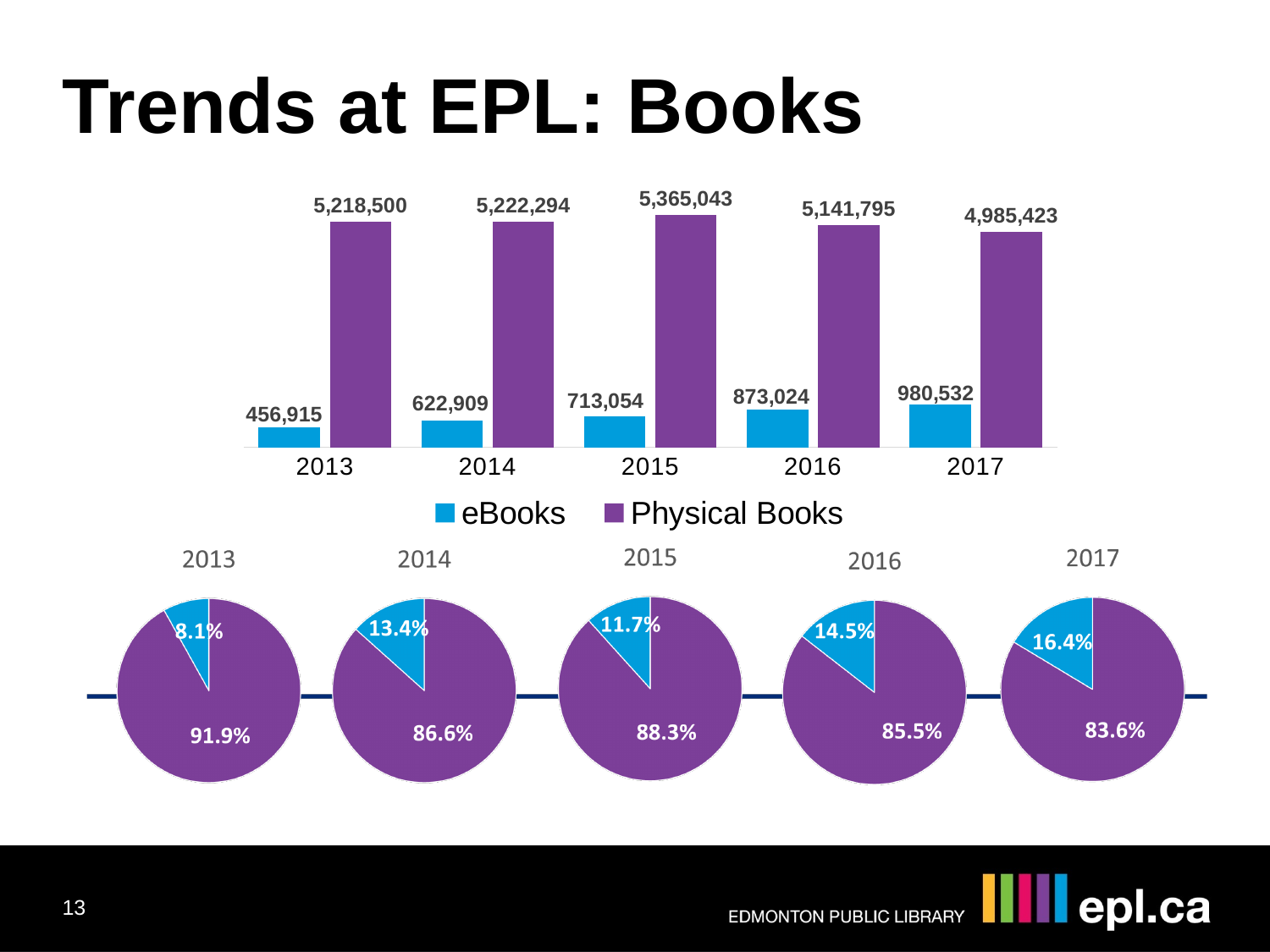
In the bar chart, what is the value for eBooks in 2015? 713,054 In the bar chart, which year has the highest value for Physical Books? 2015 What kind of chart is the top chart on the slide? bar chart How many series does the legend of the bar chart list? 2 In the bar chart, which is larger: Physical Books in 2014 or Physical Books in 2016? Physical Books in 2014 How many pie charts are shown on the slide? 5 In the 2016 pie chart, what share is shown for the blue (eBooks) slice? 14.5% In the bar chart, what is the difference between the eBooks values for 2017 and 2013? 523,617 In the bar chart, which year has the lowest value for eBooks? 2013 In the bar chart, do the eBooks values rise or fall from 2013 to 2017? rise In the bar chart, what is the value for Physical Books in 2017? 4,985,423 In the 2013 pie chart, what share is shown for the purple (Physical Books) slice? 91.9%